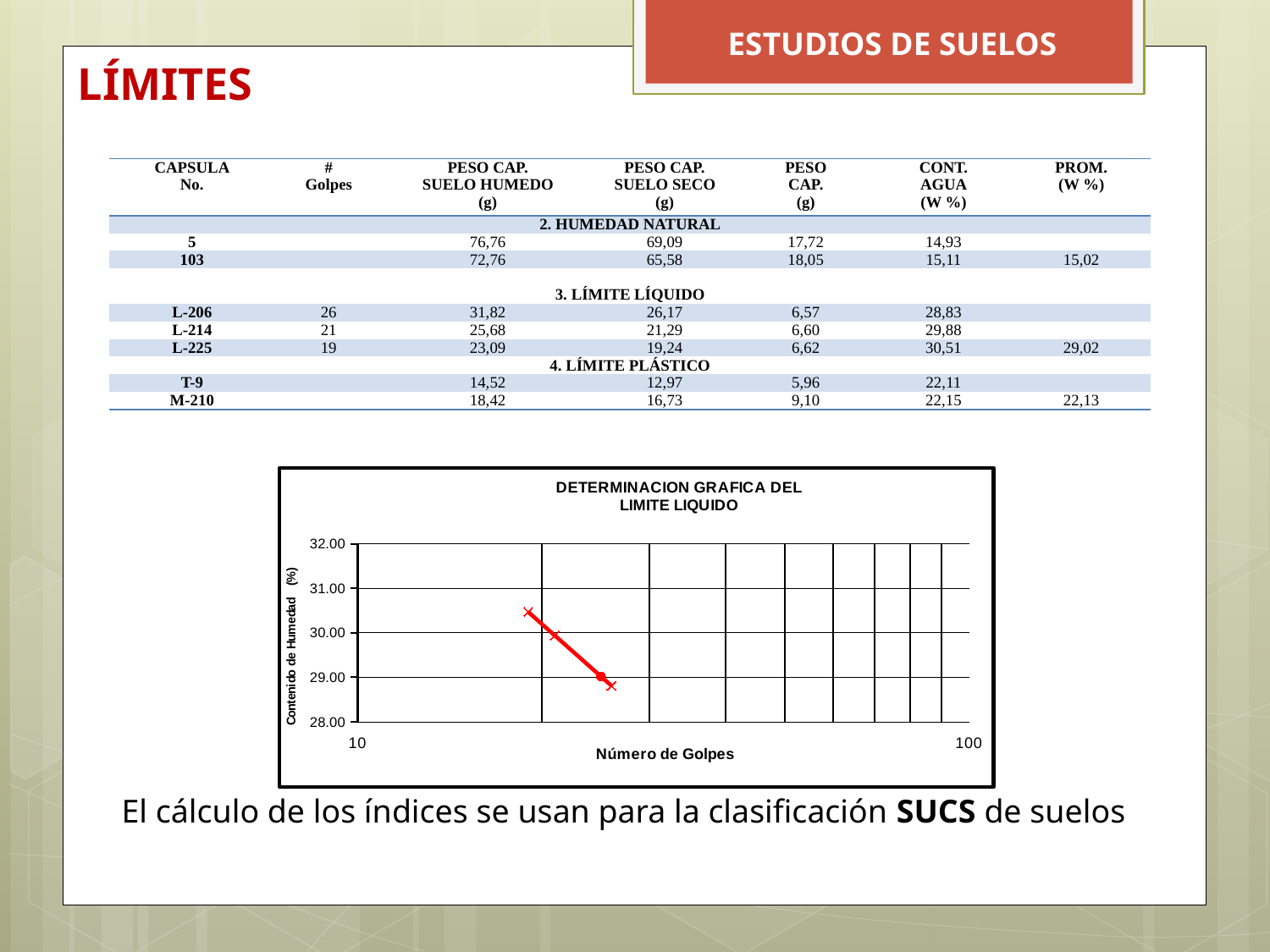
Is the value of the leftmost plotted point greater or less than 30.00? greater Is the value of the middle plotted point greater or less than 31.00? less What is the highest value shown on the y axis of the chart? 32.00 Do the plotted values rise or fall as the number of blows increases along the x axis? Fall What kind of chart is shown under the table? Scatter chart with a trend line What is the title of the chart on the slide? DETERMINACION GRAFICA DEL LIMITE LIQUIDO What is the label of the x axis of the chart? Número de Golpes Is the value of the rightmost plotted point greater or less than 29.00? less Which plotted point has the highest moisture content, the leftmost or the rightmost? The leftmost